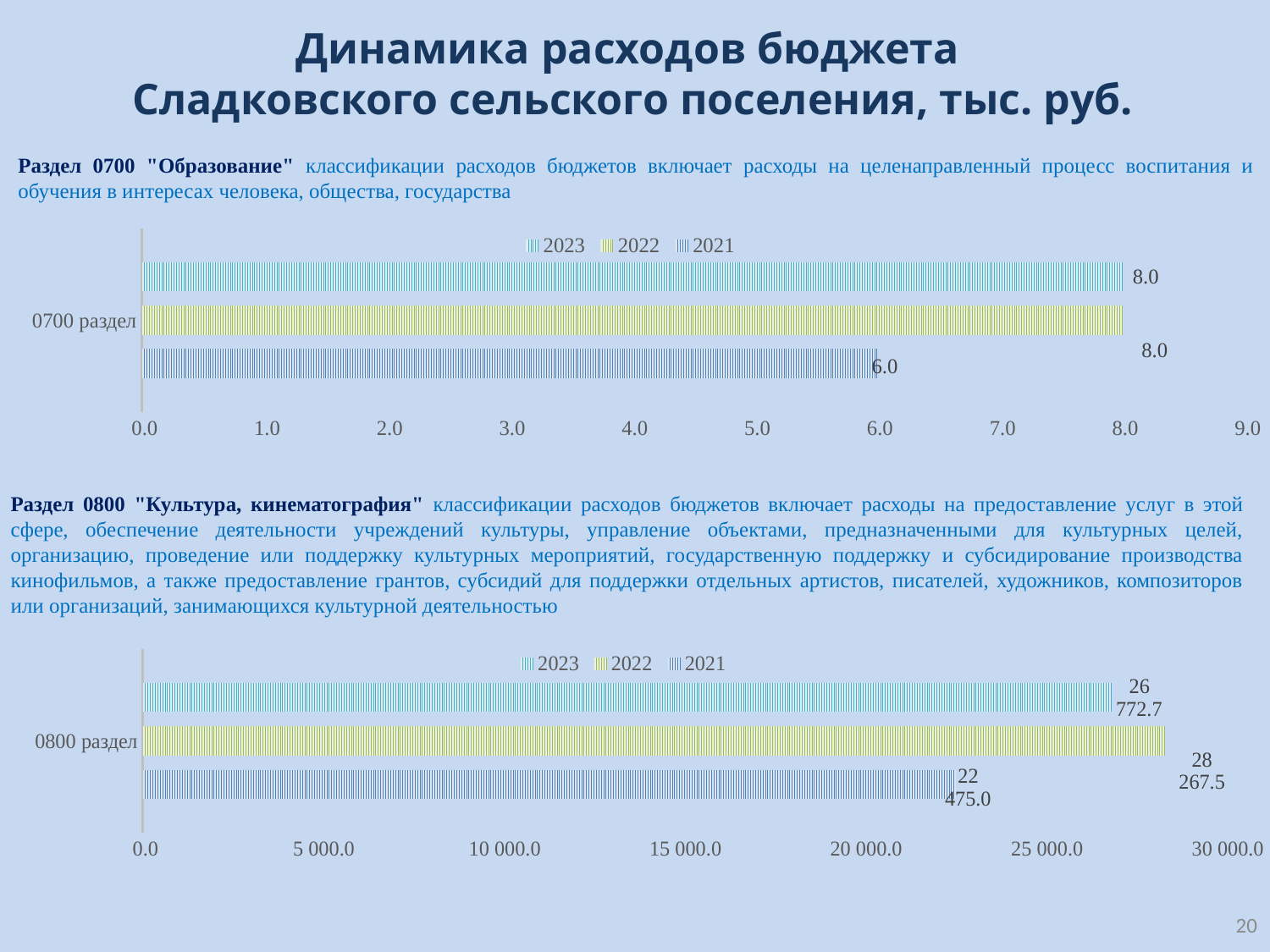
In the top chart (0700 раздел), what is the value for 2023? 8.0 In the top chart (0700 раздел), what is the value for 2021? 6.0 In the bottom chart (0800 раздел), is the value for 2023 larger or smaller than the value for 2021? larger In the top chart (0700 раздел), how many series does the legend list? 3 What kind of chart is the top chart (0700 раздел)? bar chart In the bottom chart (0800 раздел), which series is shown in the darkest blue colour? 2021 In the top chart (0700 раздел), what is the difference between the 2022 value and the 2021 value? 2.0 In the bottom chart (0800 раздел), is the value for 2021 greater or less than 25 000.0? less In the bottom chart (0800 раздел), what is the value for 2021? 22 475.0 In the top chart (0700 раздел), which year has the lowest value? 2021 In the bottom chart (0800 раздел), what is the value for 2022? 28 267.5 In the bottom chart (0800 раздел), which year has the highest value? 2022